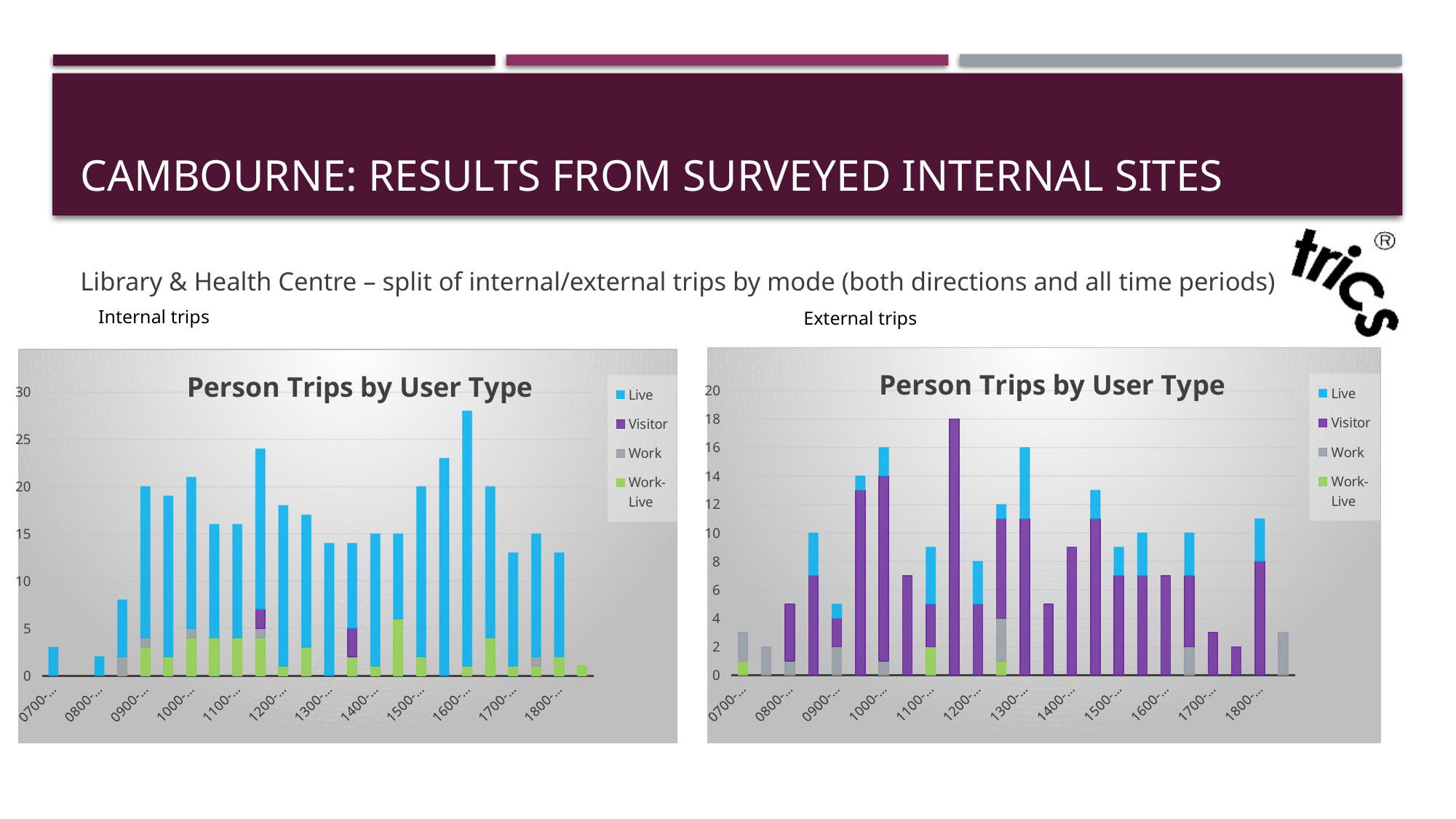
In the External trips chart, which series accounts for more of the bar heights overall, Live or Visitor? Visitor What is the title of the Internal trips chart? Person Trips by User Type How many series does the legend of the External trips chart list? 4 In the Internal trips chart, is the value of the tallest bar greater or less than 25? greater Which chart has the higher maximum value on its y axis, the Internal trips chart or the External trips chart? Internal trips chart In the Internal trips chart, which series accounts for more of the bar heights overall, Live or Visitor? Live How many time-period labels are shown on the x axis of the Internal trips chart? 12 In the External trips chart, which colour represents the Visitor series? Purple In the External trips chart, is the total of the first bar (0700) greater or less than 4? less In the External trips chart, is the value of the tallest bar greater or less than 16? greater What type of chart is the Internal trips chart? Stacked bar chart